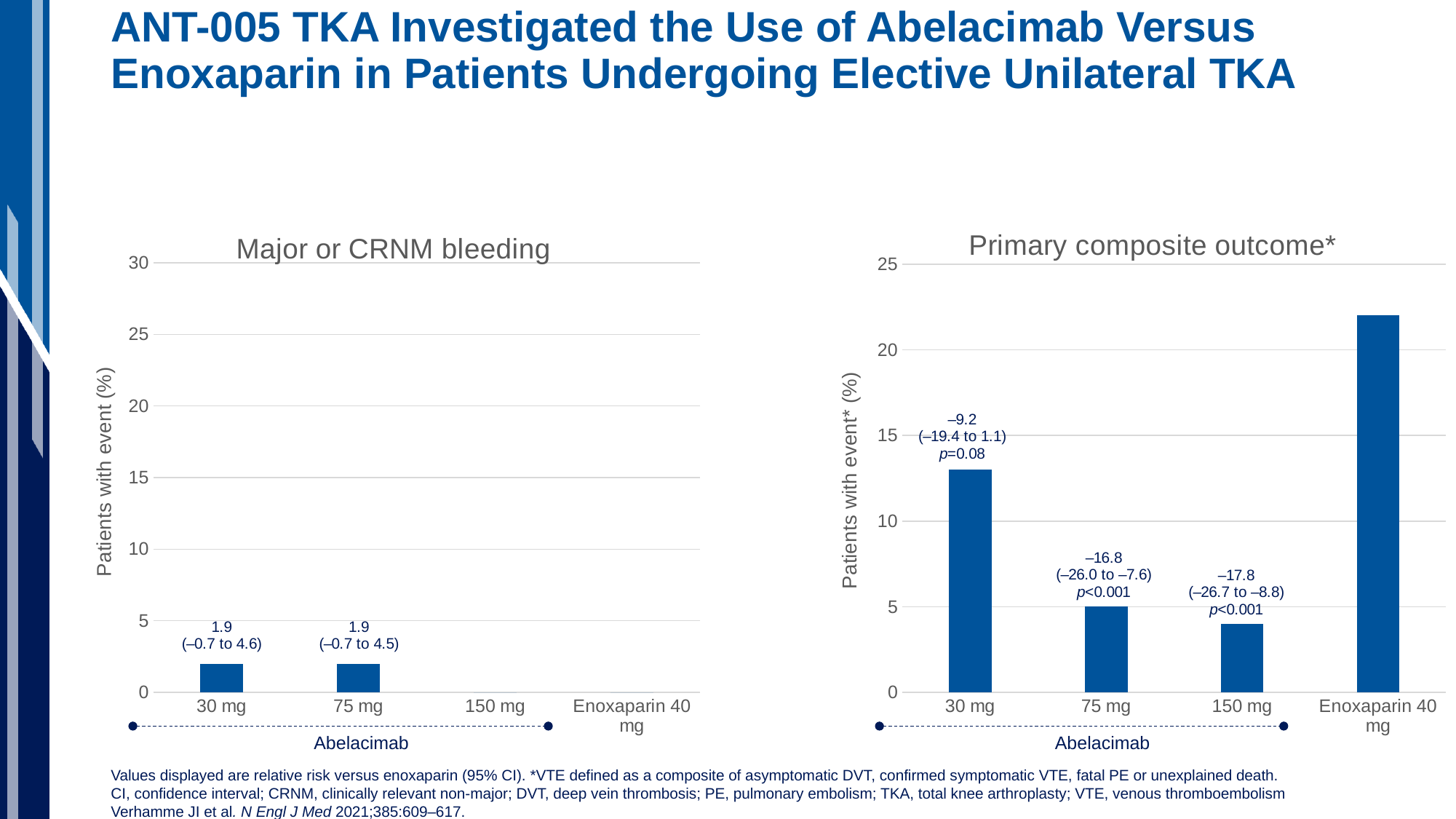
In the 'Primary composite outcome*' chart, is the value for Enoxaparin 40 mg greater or less than 20? greater What kind of chart is the 'Primary composite outcome*' chart? bar chart In the 'Major or CRNM bleeding' chart, what relative risk value (with 95% CI) is printed above the 30 mg bar? 1.9 (–0.7 to 4.6) In the 'Primary composite outcome*' chart, which bar is taller: 30 mg or 75 mg? 30 mg In the 'Primary composite outcome*' chart, which category has the highest bar? Enoxaparin 40 mg In the 'Primary composite outcome*' chart, is the value for 150 mg greater or less than 5? less In the 'Primary composite outcome*' chart, what relative risk value (with 95% CI) is printed above the 75 mg bar? –16.8 (–26.0 to –7.6) In the 'Primary composite outcome*' chart, what p-value is printed above the 30 mg bar? p=0.08 In the 'Major or CRNM bleeding' chart, is the value for 30 mg greater or less than 5? less How many categories are shown on the x axis of the 'Primary composite outcome*' chart? 4 What is the y-axis title of the 'Major or CRNM bleeding' chart? Patients with event (%)